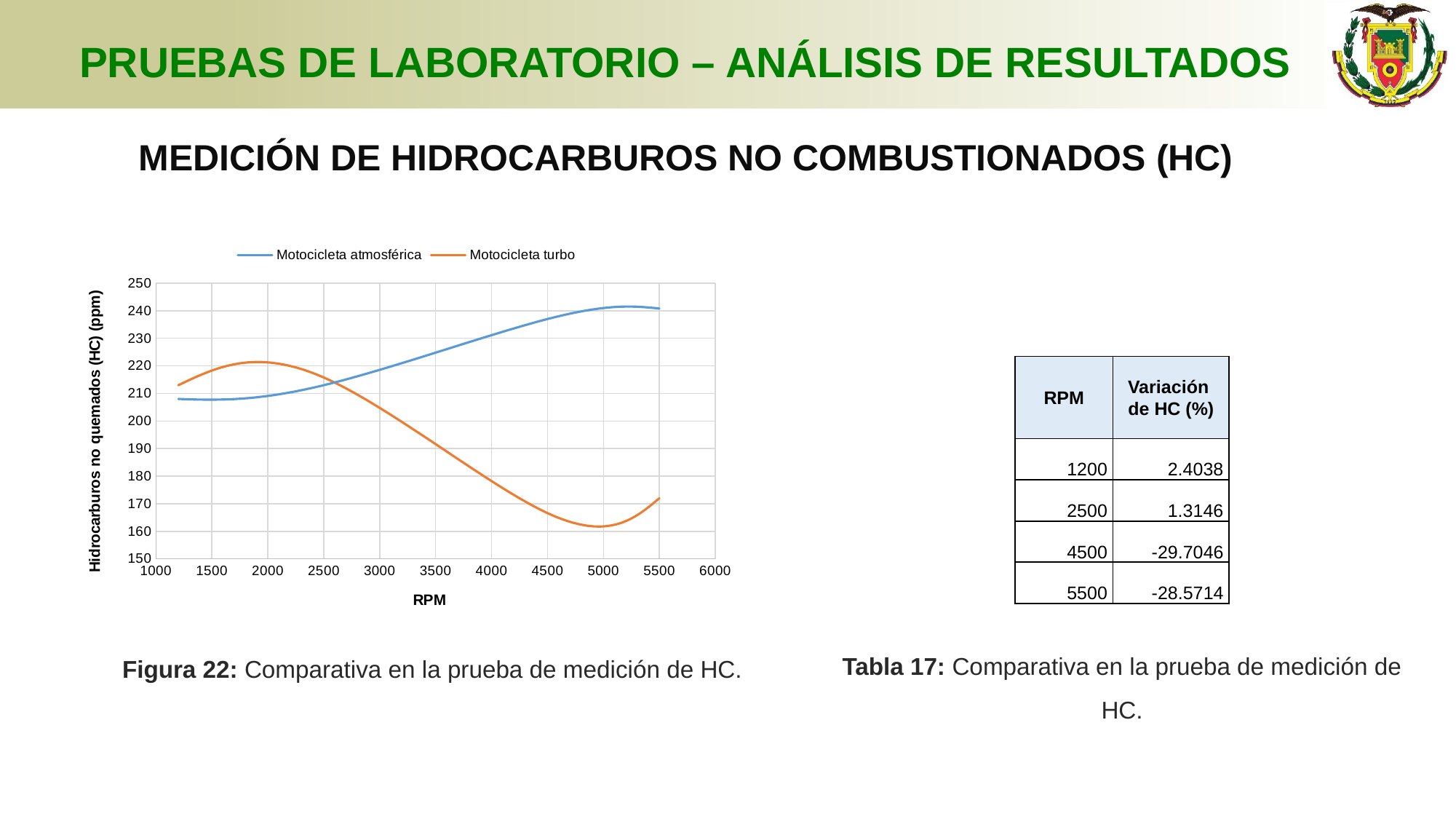
What are the two series named in the chart legend? Motocicleta atmosférica and Motocicleta turbo At 5000 RPM, which series has the higher HC value, Motocicleta atmosférica or Motocicleta turbo? Motocicleta atmosférica How many series does the legend of the chart list? 2 Is the value for Motocicleta turbo at 5000 RPM greater or less than 170? less Which series reaches the lowest HC value on the chart? Motocicleta turbo Is the value for Motocicleta turbo at 1200 RPM greater or less than 200? greater At 1500 RPM, which series has the higher HC value, Motocicleta atmosférica or Motocicleta turbo? Motocicleta turbo What kind of chart is shown in Figura 22? line chart What is the label of the y axis of the chart? Hidrocarburos no quemados (HC) (ppm) Is the value for Motocicleta atmosférica at 5500 RPM greater or less than 230? greater Does the Motocicleta atmosférica line generally rise or fall as RPM increases? rise